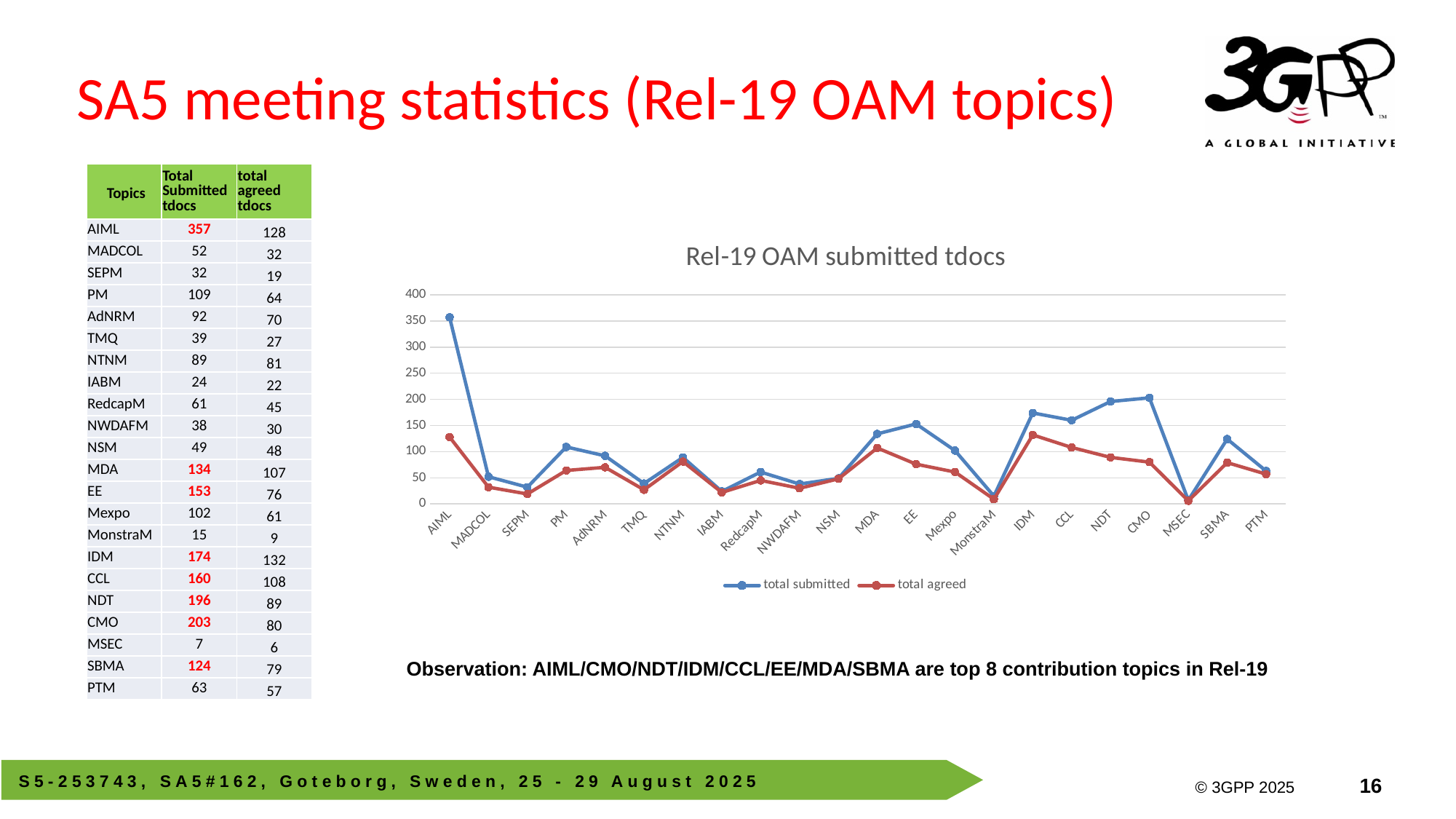
Which has the larger total submitted value, EE or MDA? EE Is the total submitted value for NDT greater or less than 150? greater Which colour is used for the total agreed series in the chart? red How many topics are plotted along the x axis of the chart? 22 Which topic has the lowest total submitted value in the chart? MSEC Is the total submitted value for AIML greater or less than 300? greater What kind of chart is shown on the slide? line chart Is the total agreed value for IDM greater or less than 100? greater Which topic has the highest total submitted value in the chart? AIML What is the title of the chart? Rel-19 OAM submitted tdocs How many series does the chart legend list? 2 Between CMO and MSEC, does the total submitted line rise or fall? fall